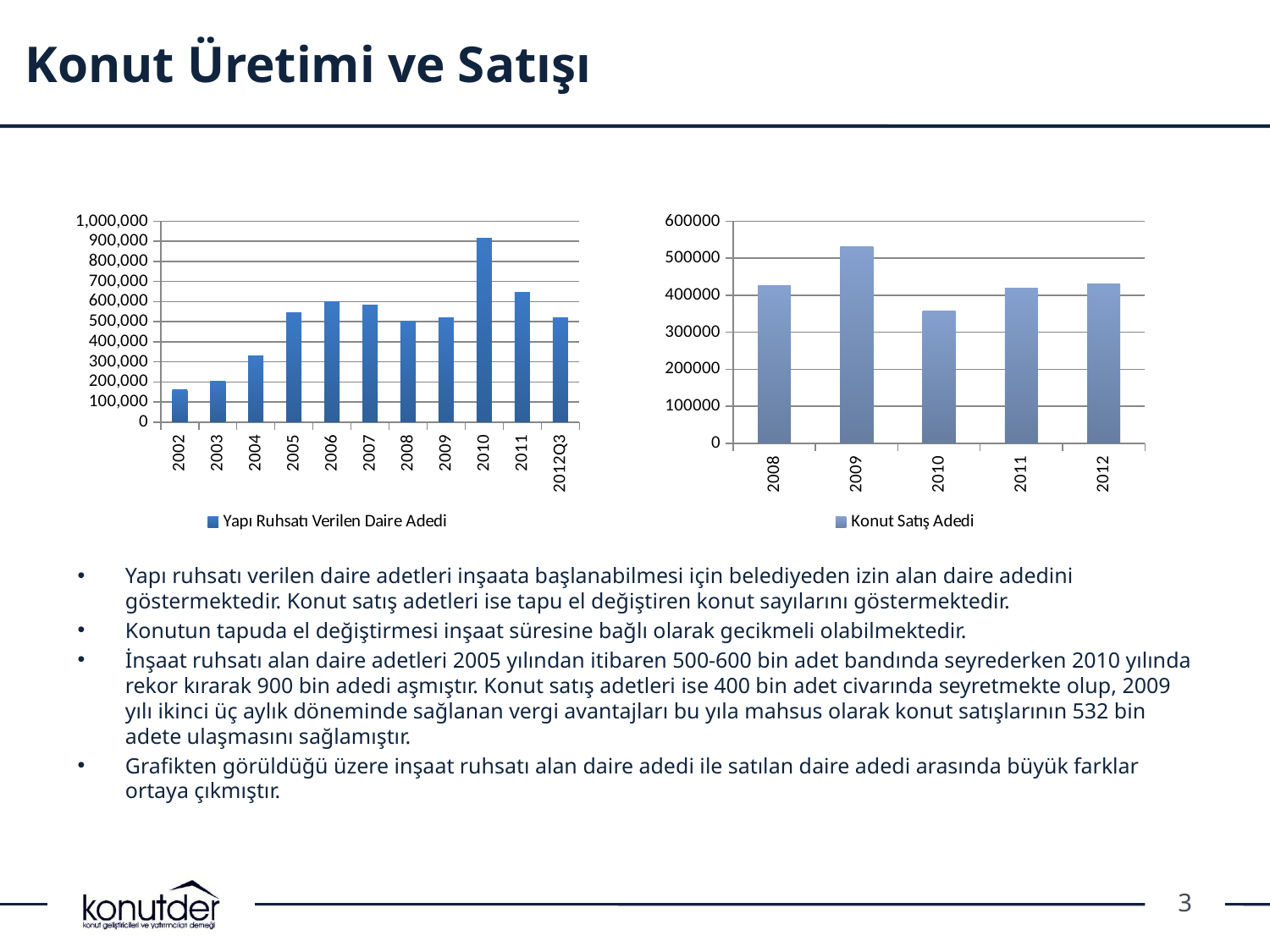
In the right chart (Konut Satış Adedi), is the value for 2010 greater or less than 400000? less How many categories are shown on the x axis of the right chart (Konut Satış Adedi)? 5 In the right chart (Konut Satış Adedi), which year has the lowest value? 2010 In the left chart (Yapı Ruhsatı Verilen Daire Adedi), do the values rise or fall from 2002 to 2006? rise In the right chart (Konut Satış Adedi), which year has the highest value? 2009 In the left chart (Yapı Ruhsatı Verilen Daire Adedi), which is larger, the value for 2006 or the value for 2008? 2006 How many categories are shown on the x axis of the left chart (Yapı Ruhsatı Verilen Daire Adedi)? 11 In the left chart (Yapı Ruhsatı Verilen Daire Adedi), is the value for 2002 greater or less than 200,000? less What kind of chart is the left chart (Yapı Ruhsatı Verilen Daire Adedi)? Bar chart In the left chart (Yapı Ruhsatı Verilen Daire Adedi), is the value for 2010 greater or less than 800,000? greater In the left chart (Yapı Ruhsatı Verilen Daire Adedi), which year has the lowest value? 2002 In the left chart (Yapı Ruhsatı Verilen Daire Adedi), which year has the highest value? 2010